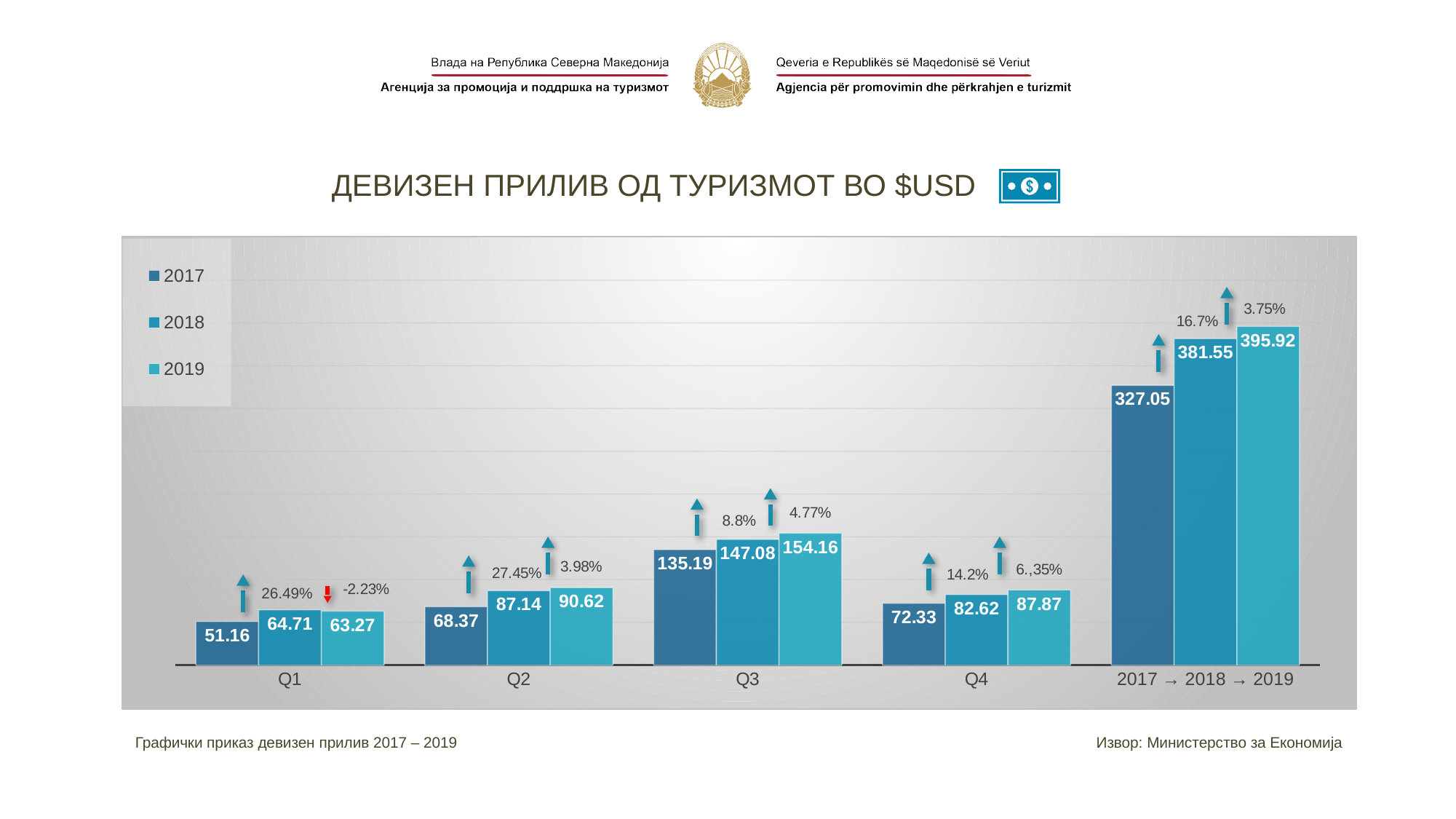
Do the values for Q2 rise or fall from 2017 to 2019? Rise What is the value for 2019 in Q4? 87.87 What kind of chart is shown on the slide? Bar chart Which is larger in Q1: the value for 2018 or the value for 2019? 2018 What is the value for 2018 in Q3? 147.08 Which quarter has the highest value for 2019? Q3 What is the value for 2019 in the annual category (2017 → 2018 → 2019)? 395.92 How many series does the legend list? 3 Which quarter has the lowest value for 2017? Q1 What is the value for 2017 in Q1? 51.16 What percentage change is shown between 2018 and 2019 in Q1? -2.23% What is the difference between the 2018 and 2017 values in Q2? 18.77